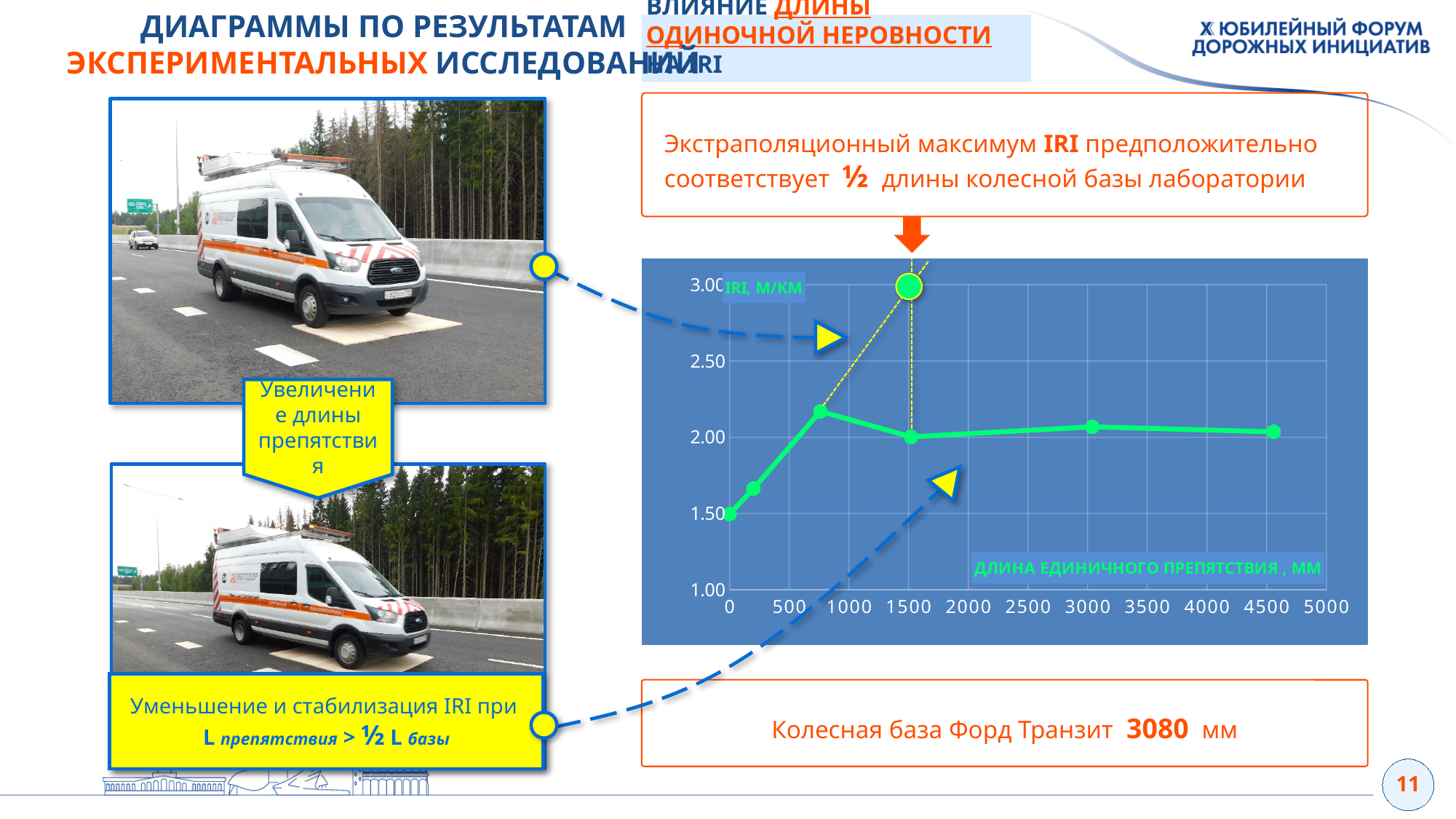
What is the label of the horizontal axis of the chart? ДЛИНА ЕДИНИЧНОГО ПРЕПЯТСТВИЯ , ММ How many data points are plotted on the line chart? 6 At which obstacle length (x value) is the plotted IRI lowest? 0 Is the IRI value at obstacle length 0 greater or less than 2.00? less What is the label of the vertical axis of the chart? IRI, м/км What kind of chart is shown on the slide? line chart